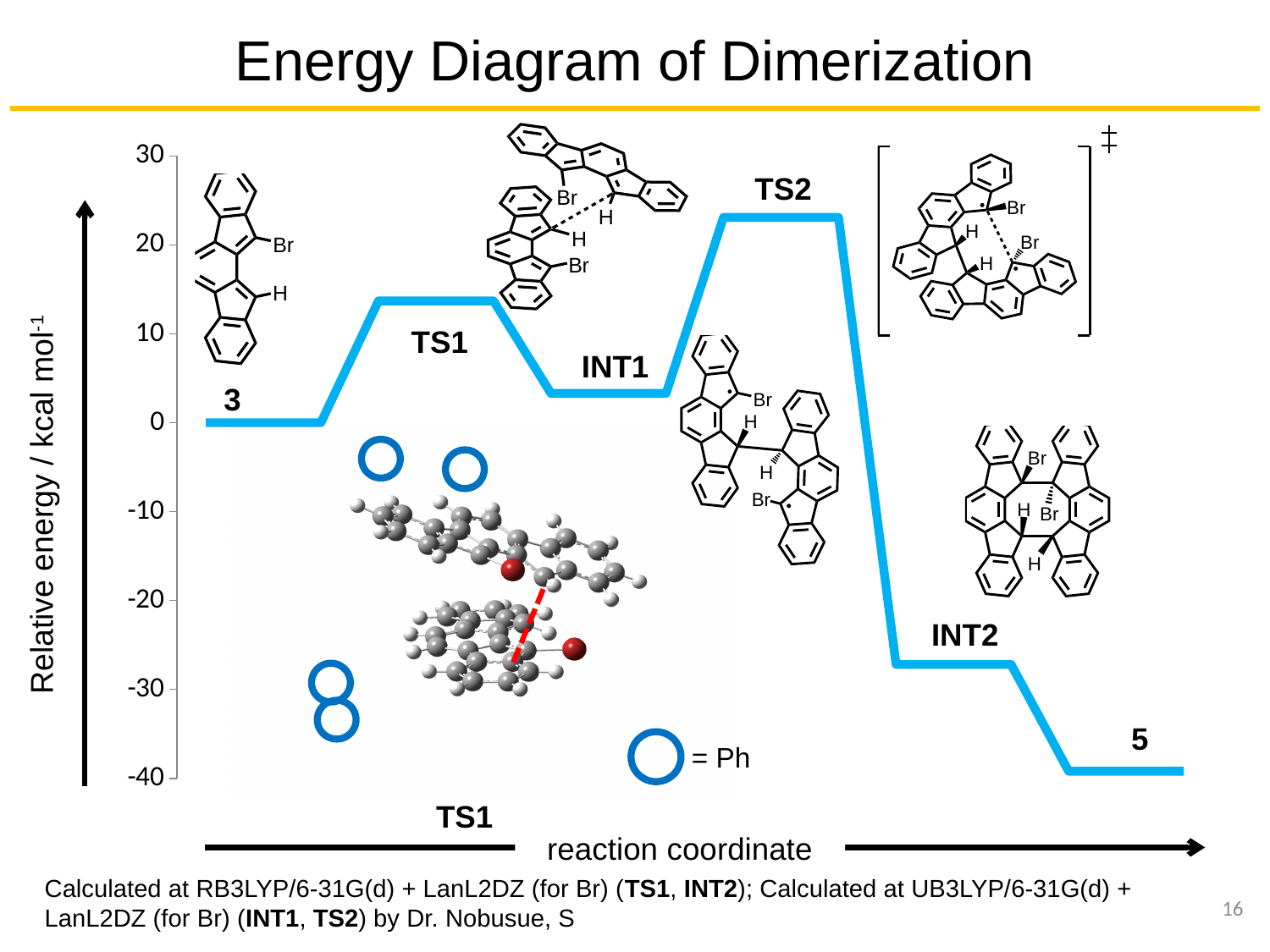
Is the relative energy of TS1 greater or less than 10? greater What is the label of the vertical axis of the energy diagram? Relative energy / kcal mol-1 What is the title of the chart on the slide? Energy Diagram of Dimerization Which labeled point on the energy diagram has the lowest relative energy? 5 Which has the higher relative energy, INT1 or INT2? INT1 Which has the higher relative energy, TS1 or TS2? TS2 Is the relative energy of INT2 greater or less than -20? less Is the relative energy of TS2 greater or less than 20? greater Which labeled point on the energy diagram has the highest relative energy? TS2 How many labeled stationary points (species and transition states) are shown along the energy profile? 6 What is the relative energy of the starting species 3 in the energy diagram? 0